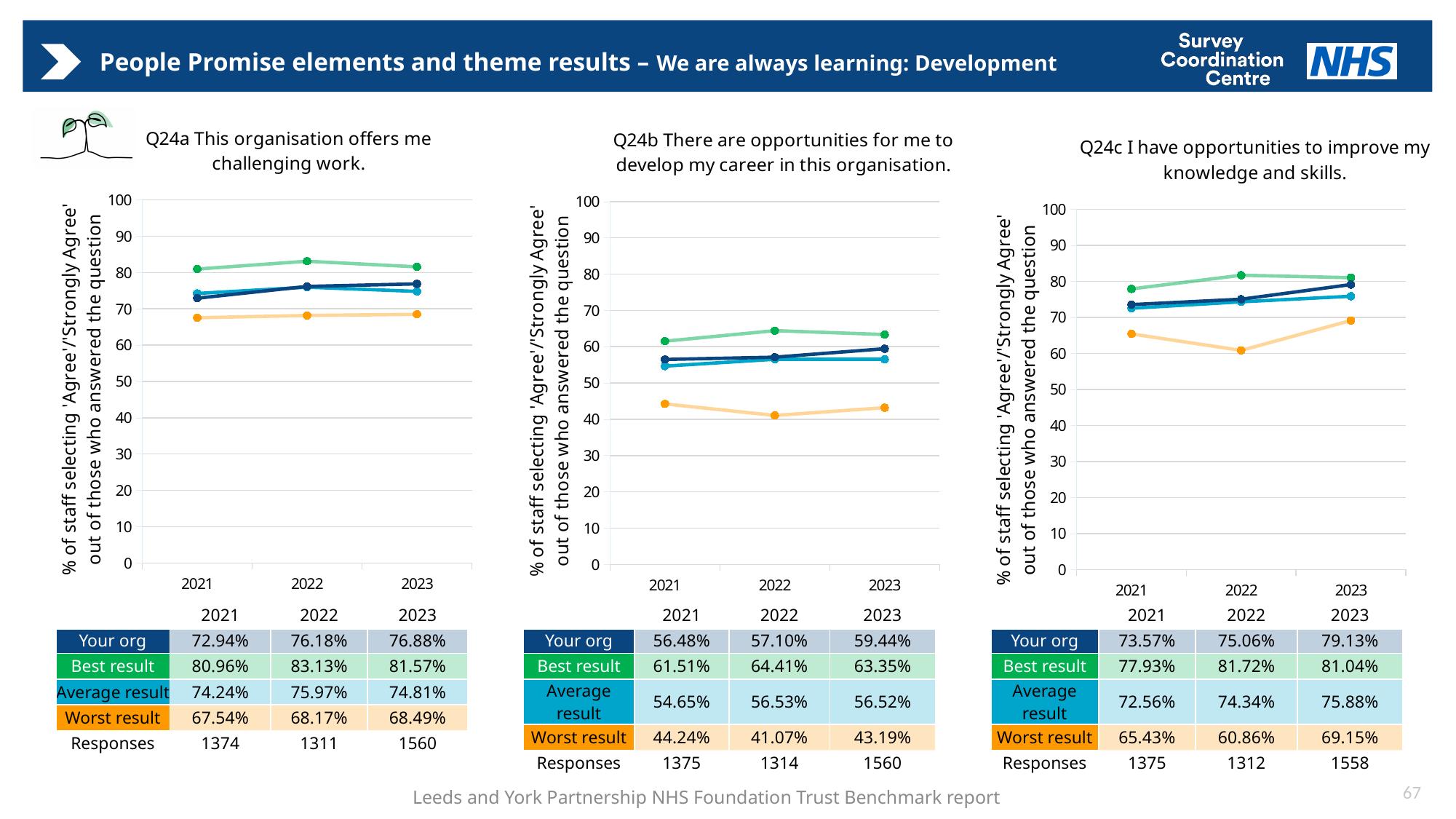
In the Q24c chart, what is the 'Best result' value for 2022? 81.72% In the Q24a chart, which year has the highest 'Best result' value? 2022 What type of chart is used for Q24b? line chart In the Q24b chart, what is the 'Worst result' value for 2022? 41.07% How many years are shown on the x axis of the Q24a chart? 3 In the Q24b chart, what is the difference between the 'Your org' value and the 'Average result' value in 2023? 2.92% How many series are plotted in the Q24c chart? 4 In the Q24c chart, is the 'Your org' value for 2023 higher or lower than the 'Average result' value for 2023? higher In the Q24b chart, does the 'Your org' line rise or fall from 2021 to 2023? rise In the Q24a chart, what is the 'Your org' value for 2023? 76.88% In the Q24b chart, is the 'Worst result' value for 2021 greater or less than 50? less In the Q24c chart, which year has the lowest 'Worst result' value? 2022